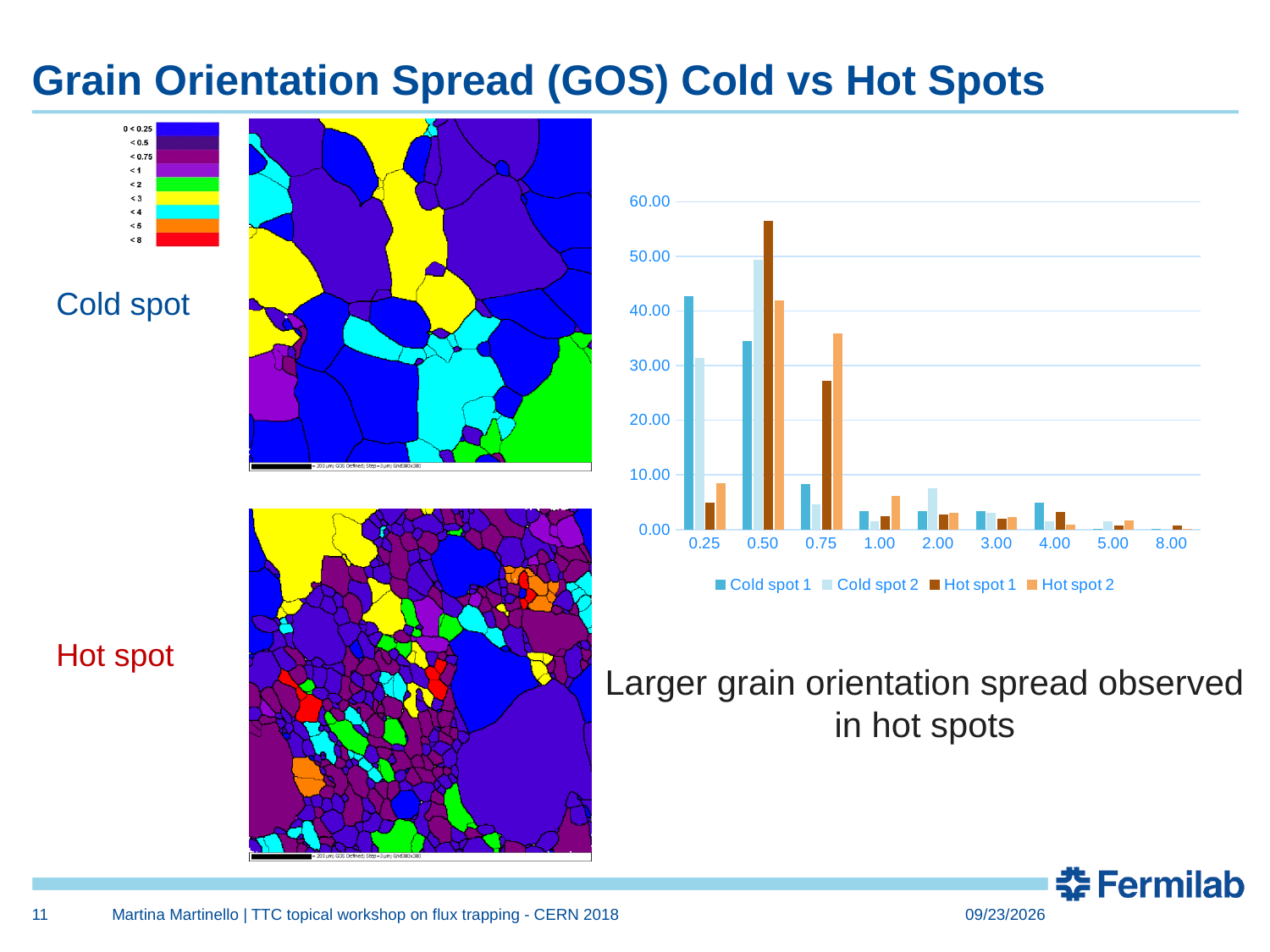
Which series has the highest value at the 0.25 category? Cold spot 1 How many categories are shown on the x axis of the chart? 9 What kind of chart is shown on the slide? bar chart Is the value for Hot spot 1 at 0.75 greater or less than 30.00? less At the 0.75 category, which is larger: Hot spot 1 or Hot spot 2? Hot spot 2 How many series does the chart legend list? 4 Is the value for Cold spot 1 at 0.25 greater or less than 40.00? greater Is the value for Hot spot 1 at 0.50 greater or less than 50.00? greater Which series has the tallest bar in the chart? Hot spot 1 At which x-axis category does Hot spot 1 reach its highest value? 0.50 Do the Hot spot 1 values rise or fall from 0.50 to 1.00 along the x axis? fall